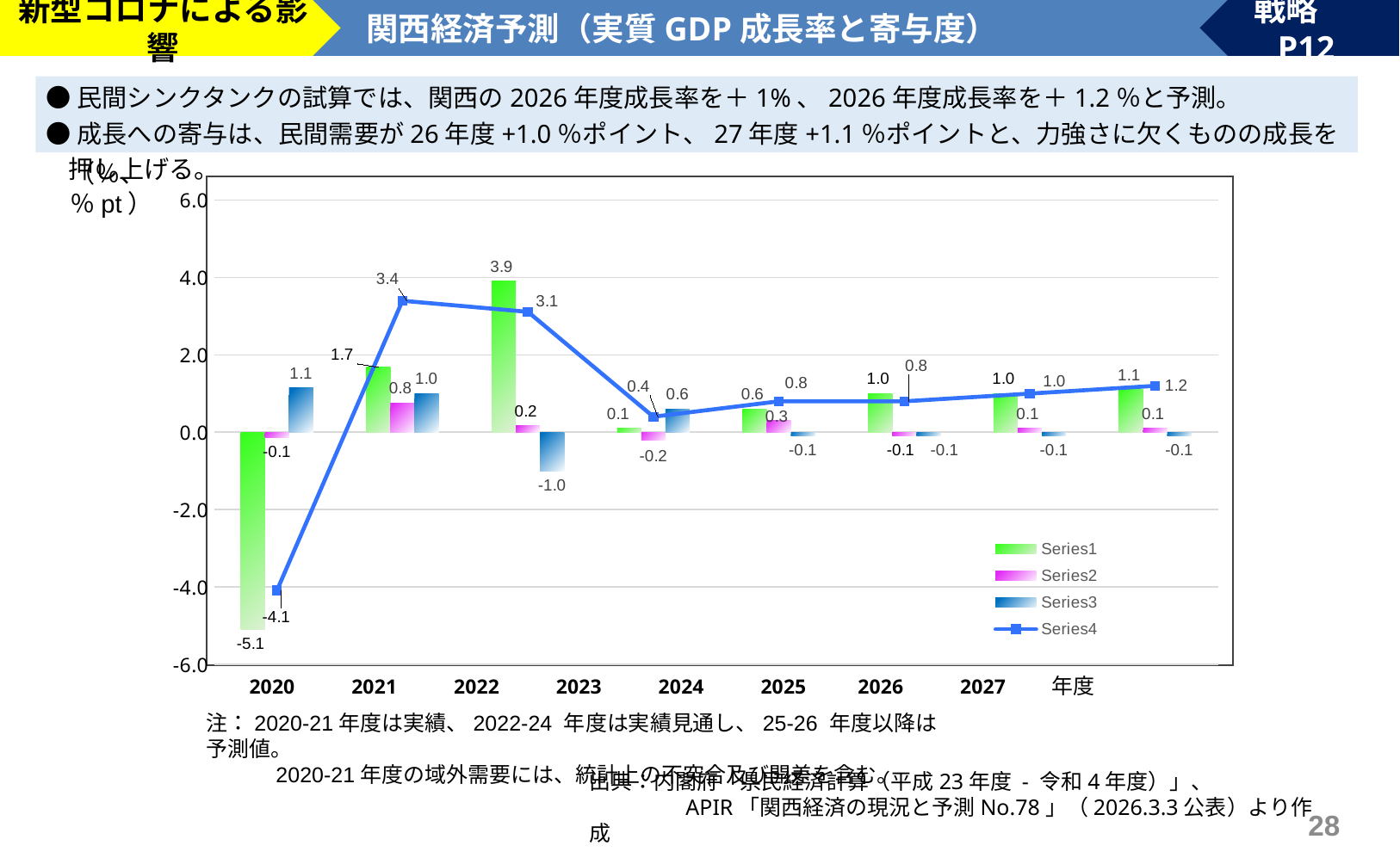
What is the value of Series3 for 2022? -1.0 Does the Series4 line rise or fall from 2020 to 2021? Rises In which year does Series1 reach its highest value? 2022 What is the difference between the Series1 values for 2022 and 2021? 2.2 Which series is drawn as a line in the legend? Series4 What is the value of Series4 (the line) for 2021? 3.4 What is the value of Series1 for 2020? -5.1 How many fiscal years are shown on the x axis? 8 In which year does Series4 (the line) reach its lowest value? 2020 How many series does the legend list? 4 For 2021, which is larger: the Series1 bar or the Series4 line value? Series4 What kind of chart is shown on the slide? A combination bar and line chart